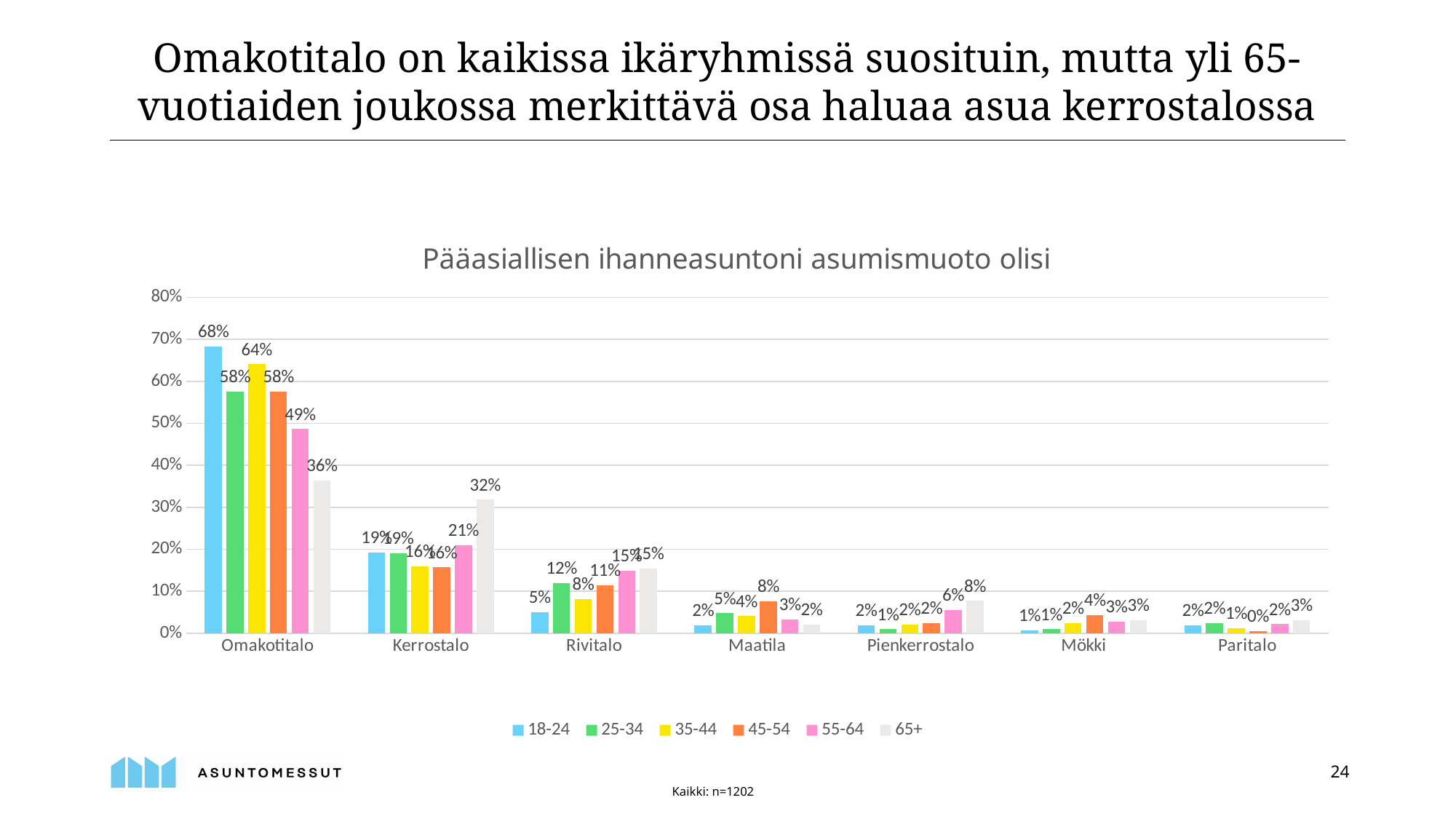
How many series does the legend list? 6 Is the value for the 35-44 series in the Omakotitalo category greater or less than 60%? greater What is the difference between the 18-24 and 65+ values in the Omakotitalo category? 32 percentage points How many housing-type categories are shown on the x axis? 7 What kind of chart is shown on the slide? Bar chart What is the title of the chart? Pääasiallisen ihanneasuntoni asumismuoto olisi Which age group has the highest value in the Omakotitalo category? 18-24 Which age group has the lowest value in the Omakotitalo category? 65+ What is the value for the 18-24 series in the Omakotitalo category? 68% What is the value for the 65+ series in the Kerrostalo category? 32% What is the value for the 45-54 series in the Maatila category? 8% In the Kerrostalo category, which is larger: the value for 55-64 or the value for 35-44? 55-64